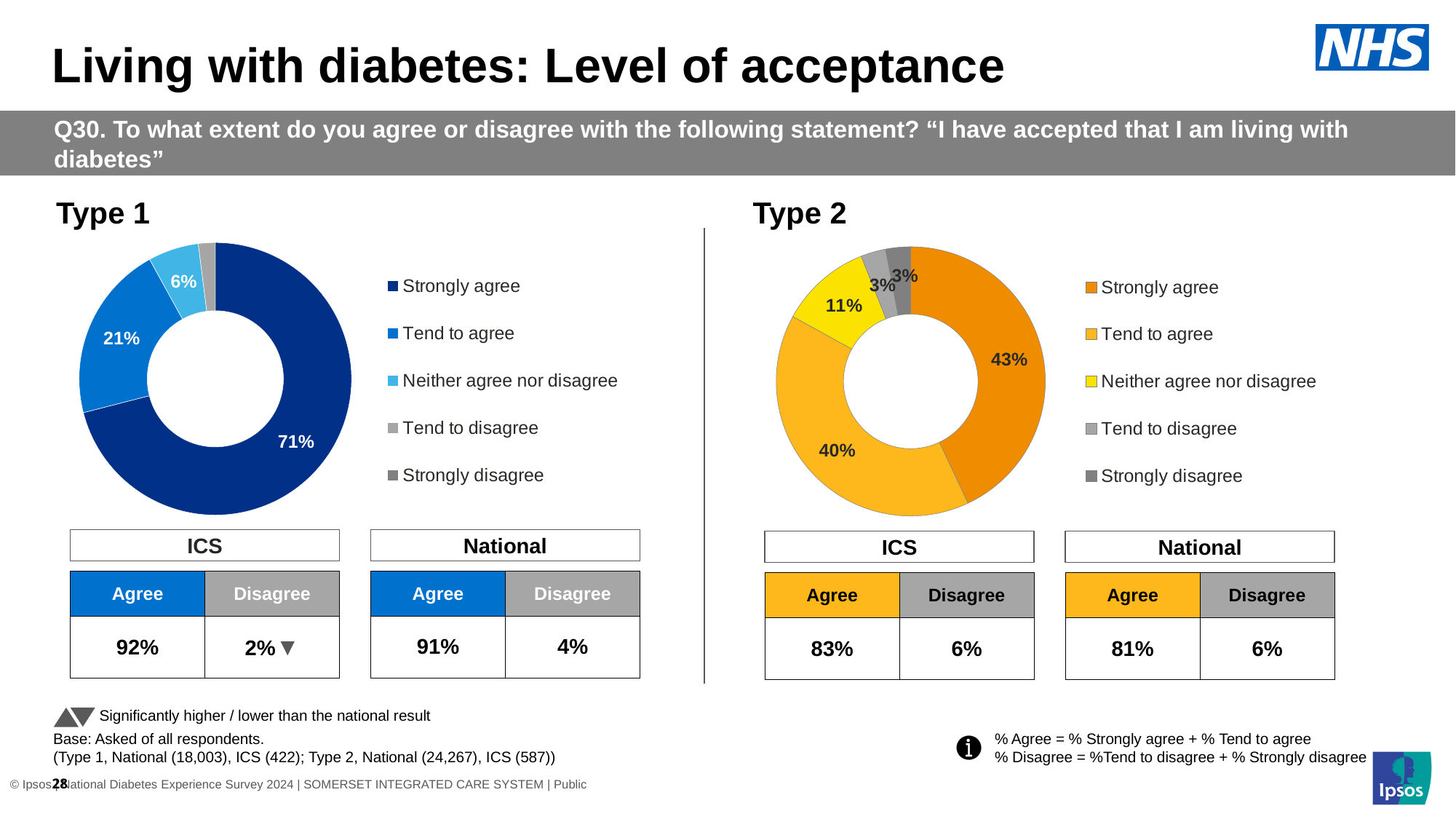
How many categories does the legend of the Type 2 chart list? 5 In the Type 1 chart, what is the difference between the Strongly agree and Tend to agree shares? 50 percentage points In the Type 2 chart, what percentage of respondents strongly agree? 43% In the Type 1 chart, what percentage neither agree nor disagree? 6% In the Type 2 chart, what is the difference between the Strongly agree and Tend to agree shares? 3 percentage points In the Type 1 chart, what percentage of respondents strongly agree? 71% In the Type 2 chart, what percentage of respondents tend to agree? 40% In the Type 2 chart, what percentage neither agree nor disagree? 11% What type of chart is used for Type 1? Donut (pie) chart In the Type 1 chart, what percentage of respondents tend to agree? 21% In the Type 1 chart, which category has the largest share? Strongly agree In the Type 2 chart, which category has the largest share? Strongly agree